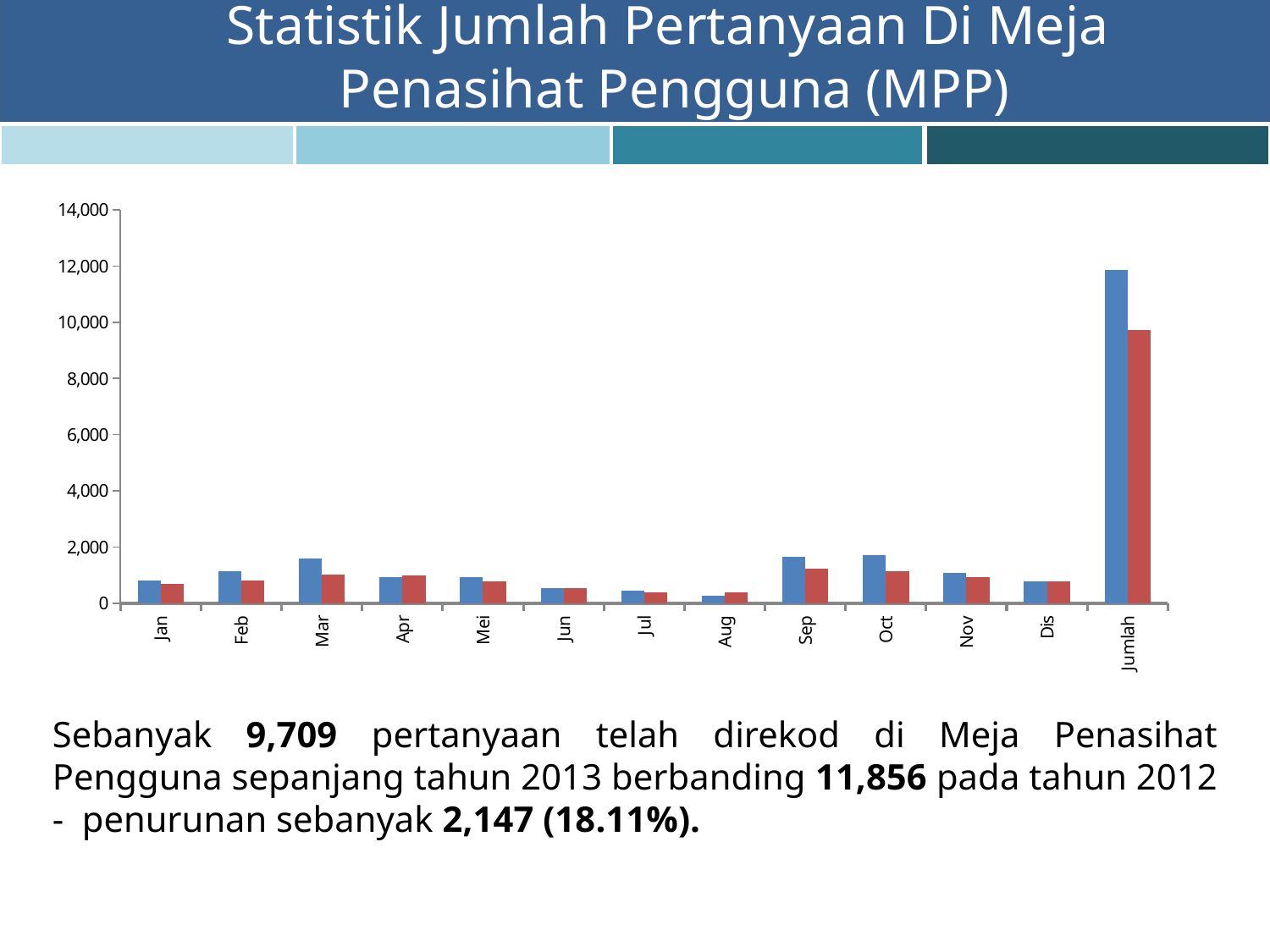
What is the title of the slide containing the chart? Statistik Jumlah Pertanyaan Di Meja Penasihat Pengguna (MPP) Which category has the highest bars in the chart? Jumlah How many bar series (colours) are plotted for each category in the chart? 2 For Oct, which bar is larger, the blue one or the red one? blue How many categories are shown on the x axis of the chart? 13 Is the blue bar for Jumlah greater or less than 10,000? greater Is the blue bar for Aug greater or less than 1,000? less Is the red bar for Jumlah greater or less than 10,000? less What kind of chart is shown on the slide? bar chart Which month (excluding Jumlah) has the lowest blue bar? Aug For Jumlah, which bar is larger, the blue one or the red one? blue